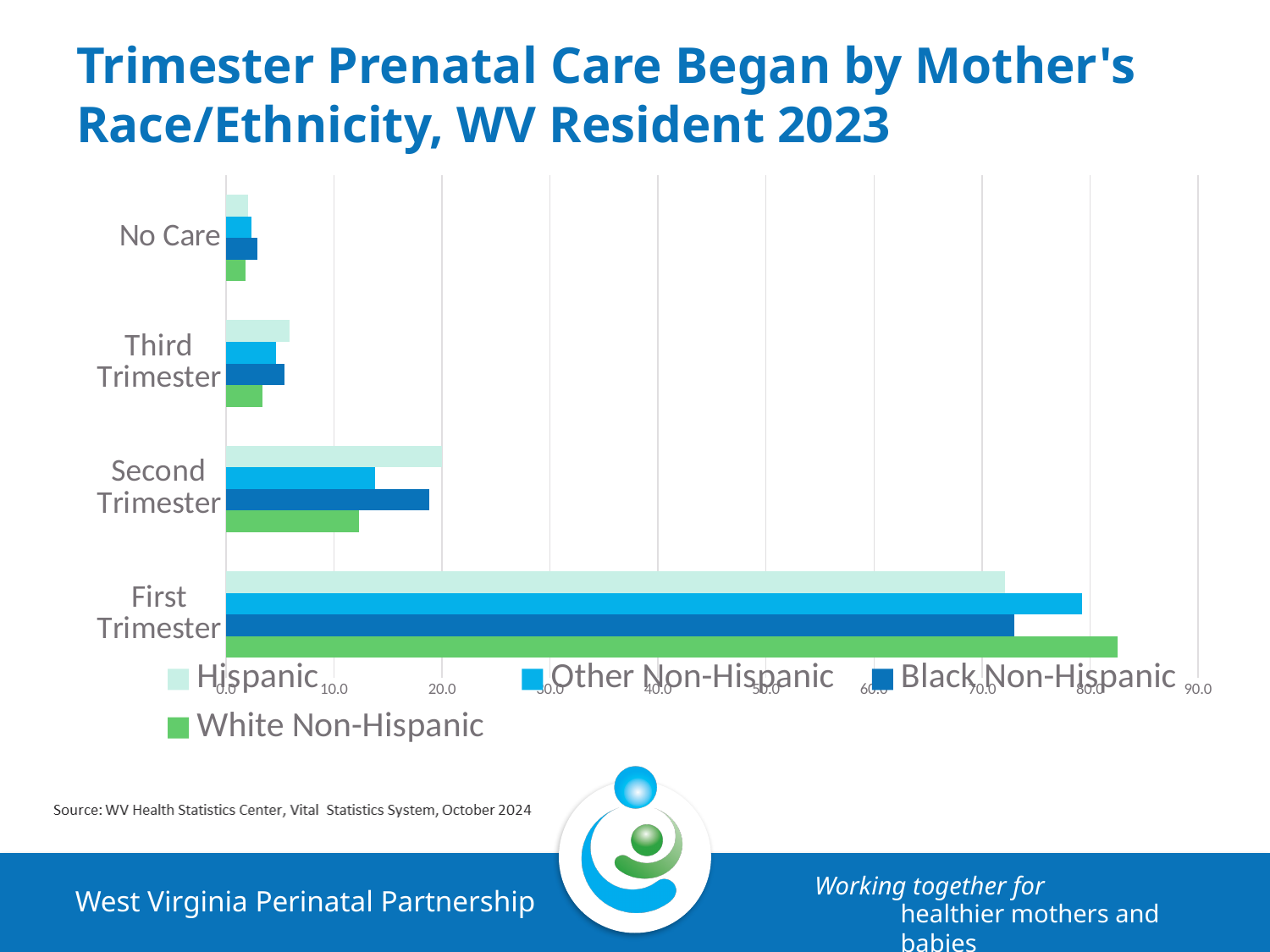
Is the value for White Non-Hispanic in the First Trimester category greater or less than 80? greater Which race/ethnicity group has the highest value for First Trimester? White Non-Hispanic What kind of chart is shown on the slide? bar chart Which category has the lowest values across all groups? No Care Is the value for Hispanic in the First Trimester category greater or less than 80? less Is the value for Other Non-Hispanic in the Second Trimester category greater or less than 20? less How many series does the legend list? 4 What is the title of the chart? Trimester Prenatal Care Began by Mother's Race/Ethnicity, WV Resident 2023 How many categories are shown on the vertical axis of the chart? 4 Which is larger in the Second Trimester category: the Hispanic value or the White Non-Hispanic value? Hispanic